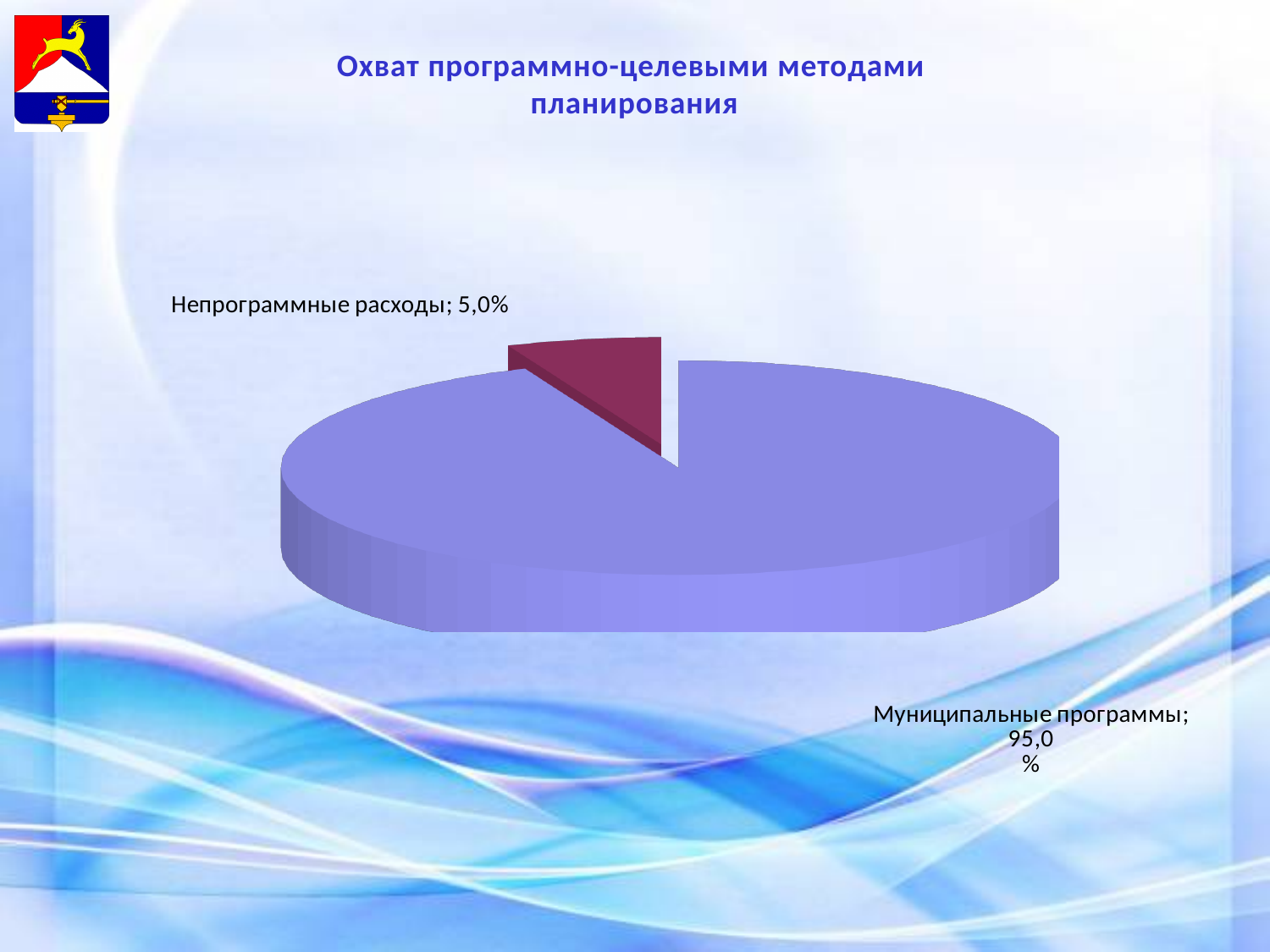
Which is larger: Непрограммные расходы or Муниципальные программы? Муниципальные программы How many slices does the pie chart have? 2 What is the title of the chart on the slide? Охват программно-целевыми методами планирования What is the value for Непрограммные расходы? 5,0% What is the value for Муниципальные программы? 95,0% What type of chart is shown on the slide? pie chart What share of the pie does Муниципальные программы represent? 95,0% Which category has the smallest share of the pie? Непрограммные расходы Which category has the largest share of the pie? Муниципальные программы What colour is the slice for Непрограммные расходы? dark red What is the difference between the shares of Муниципальные программы and Непрограммные расходы? 90,0%